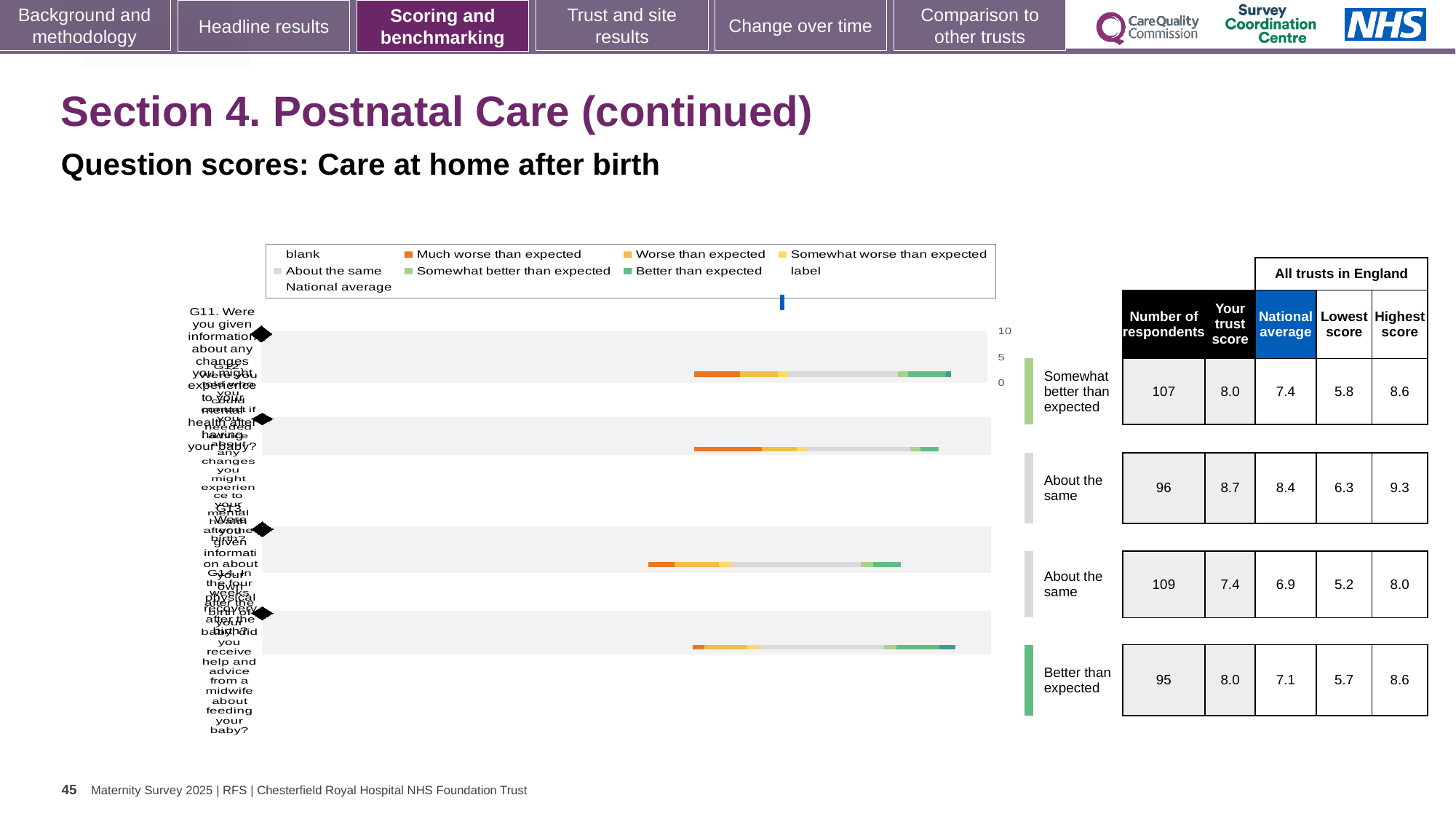
In the table to the right of the chart, is 'Your trust score' for the 'Somewhat better than expected' row higher or lower than the national average? higher In the table to the right of the chart, what is the lowest score for the 'Somewhat better than expected' row? 5.8 In the table to the right of the chart, what is the number of respondents for the 'Somewhat better than expected' row? 107 How many bars (question rows) are plotted in the chart? 4 In the table to the right of the chart, what is the largest 'Your trust score' value across the four rows? 8.7 What is the highest tick value shown on the chart's axis? 10 In the chart legend, what colour represents 'Much worse than expected'? orange In the table to the right of the chart, what is the highest score for the second row (the first 'About the same' row)? 9.3 In the table to the right of the chart, what is the 'Your trust score' for the 'Better than expected' row? 8.0 What kind of chart is shown on the slide? bar chart In the table to the right of the chart, what is the difference between 'Your trust score' and the national average for the 'Better than expected' row? 0.9 In the table to the right of the chart, what is the national average for the 'Better than expected' row? 7.1